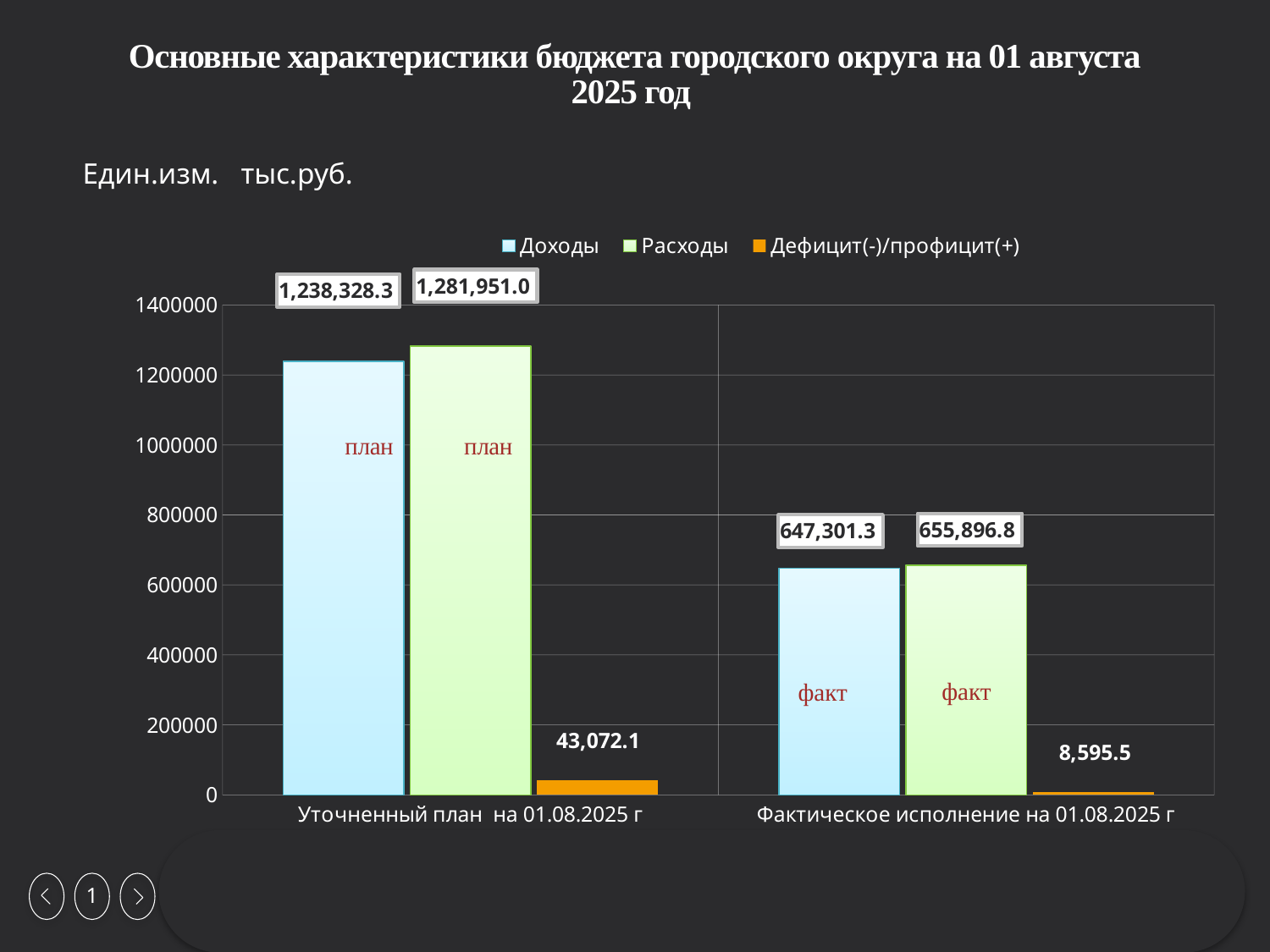
Which series has the lowest value for Фактическое исполнение на 01.08.2025 г? Дефицит(-)/профицит(+) What is the value of Доходы for Фактическое исполнение на 01.08.2025 г? 647,301.3 Which is larger: Доходы for Уточненный план на 01.08.2025 г or Доходы for Фактическое исполнение на 01.08.2025 г? Уточненный план на 01.08.2025 г What is the value of Доходы for Уточненный план на 01.08.2025 г? 1,238,328.3 What is the value of Дефицит(-)/профицит(+) for Уточненный план на 01.08.2025 г? 43,072.1 Which series has the highest value for Уточненный план на 01.08.2025 г? Расходы What kind of chart is shown on the slide? Bar chart What is the value of Расходы for Уточненный план на 01.08.2025 г? 1,281,951.0 What is the difference between Расходы and Доходы for Фактическое исполнение на 01.08.2025 г? 8,595.5 What is the value of Расходы for Фактическое исполнение на 01.08.2025 г? 655,896.8 How many series does the legend list? 3 What is the value of Дефицит(-)/профицит(+) for Фактическое исполнение на 01.08.2025 г? 8,595.5